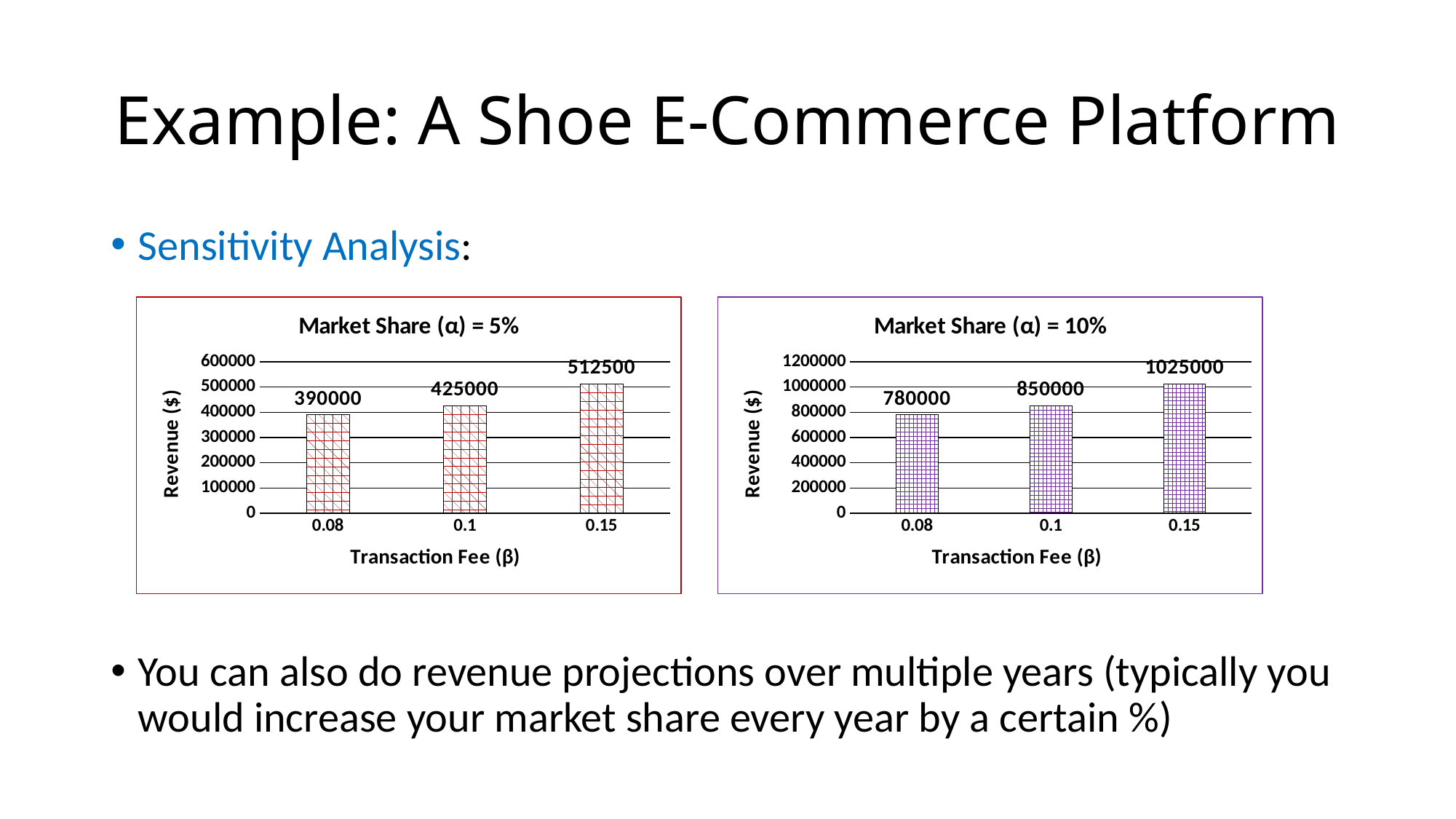
In the 'Market Share (α) = 10%' chart, what is the difference in revenue between transaction fees 0.15 and 0.08? 245000 In the 'Market Share (α) = 5%' chart, which transaction fee gives the highest revenue? 0.15 In the 'Market Share (α) = 10%' chart, which transaction fee gives the lowest revenue? 0.08 What type of chart is the 'Market Share (α) = 10%' chart? Bar chart In the 'Market Share (α) = 10%' chart, what is the revenue for a transaction fee of 0.15? 1025000 How many transaction fee categories are shown in the 'Market Share (α) = 5%' chart? 3 In the 'Market Share (α) = 5%' chart, what is the revenue for a transaction fee of 0.15? 512500 Which is larger: the revenue at transaction fee 0.1 in the 'Market Share (α) = 5%' chart or the revenue at transaction fee 0.08 in the 'Market Share (α) = 10%' chart? Revenue at 0.08 in the Market Share (α) = 10% chart In the 'Market Share (α) = 5%' chart, what is the difference in revenue between transaction fees 0.1 and 0.08? 35000 In the 'Market Share (α) = 10%' chart, what is the revenue for a transaction fee of 0.1? 850000 In the 'Market Share (α) = 5%' chart, what is the revenue for a transaction fee of 0.08? 390000 In the 'Market Share (α) = 10%' chart, does revenue rise or fall as the transaction fee increases? Rises